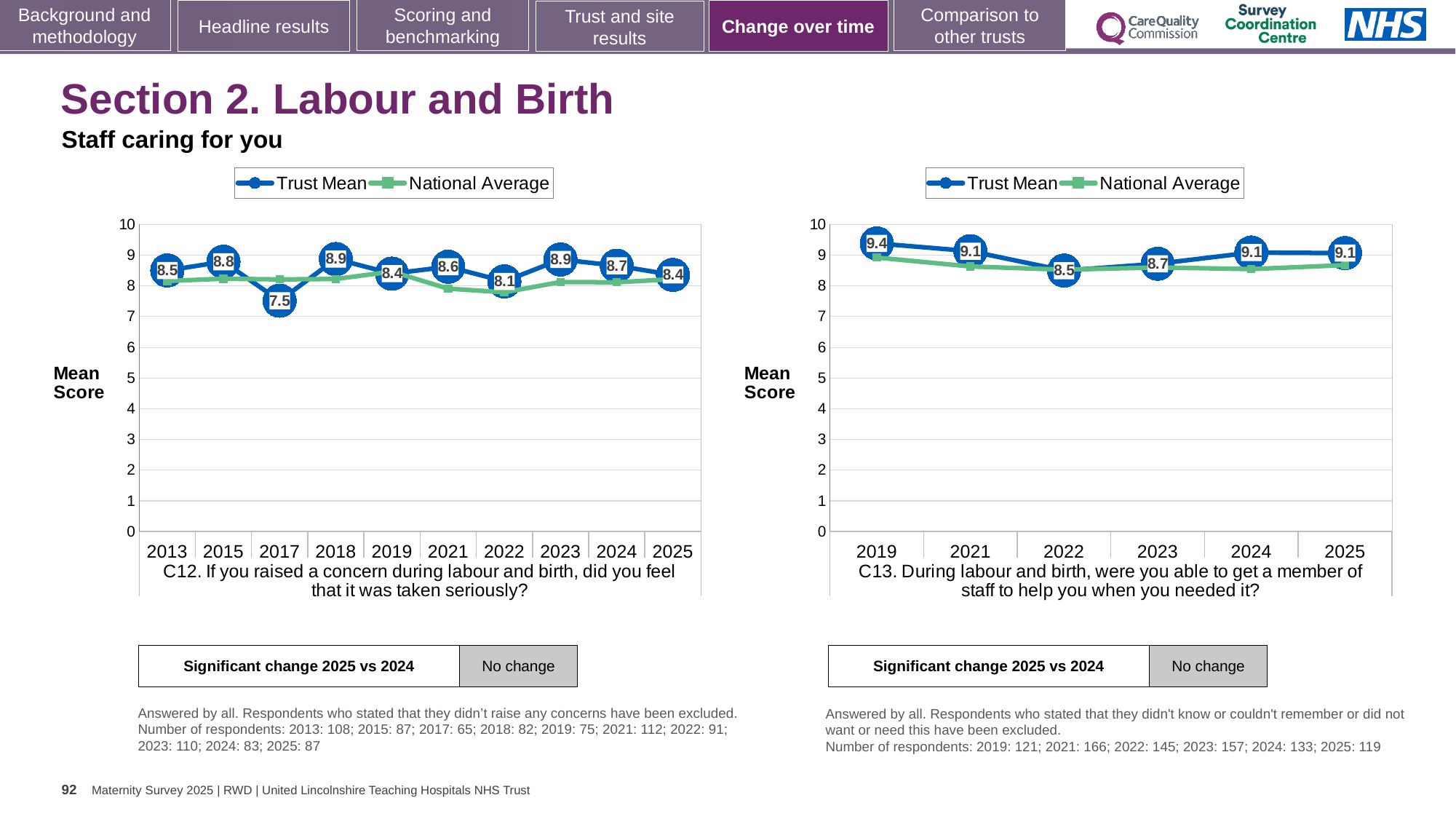
In the C12 chart on the left, what is the difference between the Trust Mean scores for 2018 and 2017? 1.4 In the C13 chart on the right, is the National Average value for 2022 greater or less than 8? greater In the C12 chart on the left, is the Trust Mean score higher in 2023 or in 2022? 2023 In the C12 chart on the left, what is the Trust Mean score for 2017? 7.5 In the C13 chart on the right, what is the difference between the Trust Mean scores for 2019 and 2022? 0.9 How many series does the legend of the C13 chart on the right list? 2 In the C13 chart on the right, what is the Trust Mean score for 2019? 9.4 In the C12 chart on the left, what is the Trust Mean score for 2025? 8.4 In the C13 chart on the right, which year has the lowest Trust Mean score? 2022 How many years are plotted on the x axis of the C12 chart on the left? 10 In the C12 chart on the left, which year has the lowest Trust Mean score? 2017 In the C13 chart on the right, which year has the highest Trust Mean score? 2019